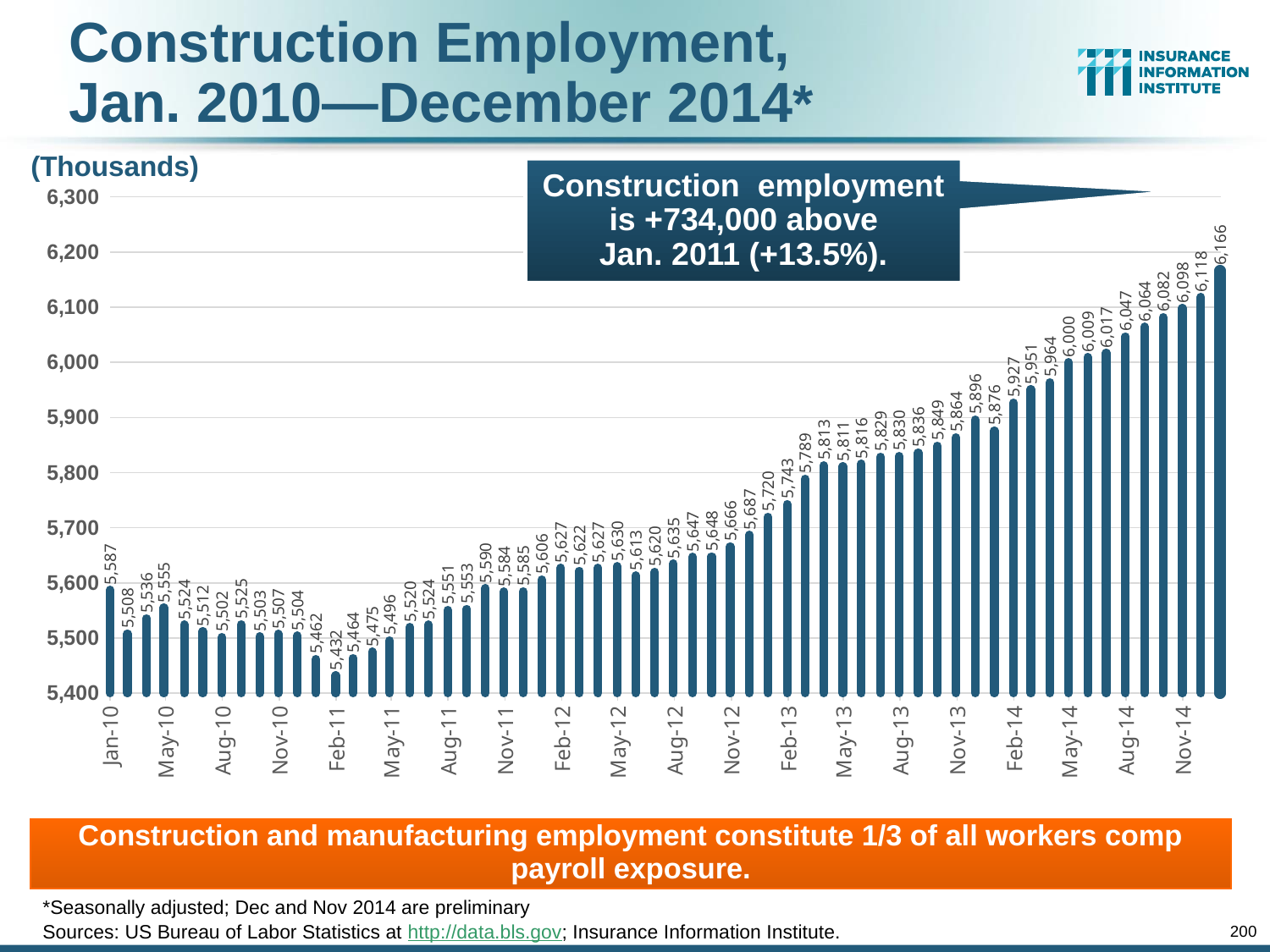
In what units are the values on the y-axis expressed, according to the label above the axis? Thousands What is the highest value shown in the chart? 6,166 What is the lowest value shown in the chart? 5,432 What is the construction employment value for Nov-14? 6,118 What is the difference between the last bar (6,166) and the Jan-10 bar (5,587)? 579 Which is larger, the value for Jan-10 or the value for Nov-14? Nov-14 What is the value of the last (rightmost) bar in the chart? 6,166 Is the value for Aug-13 greater or less than 5,800? greater Do the values generally rise or fall from Jan-10 to the end of 2014? Rise What is the construction employment value for Jan-10? 5,587 How many monthly bars are plotted in the chart? 60 What kind of chart is shown on the slide? Bar chart